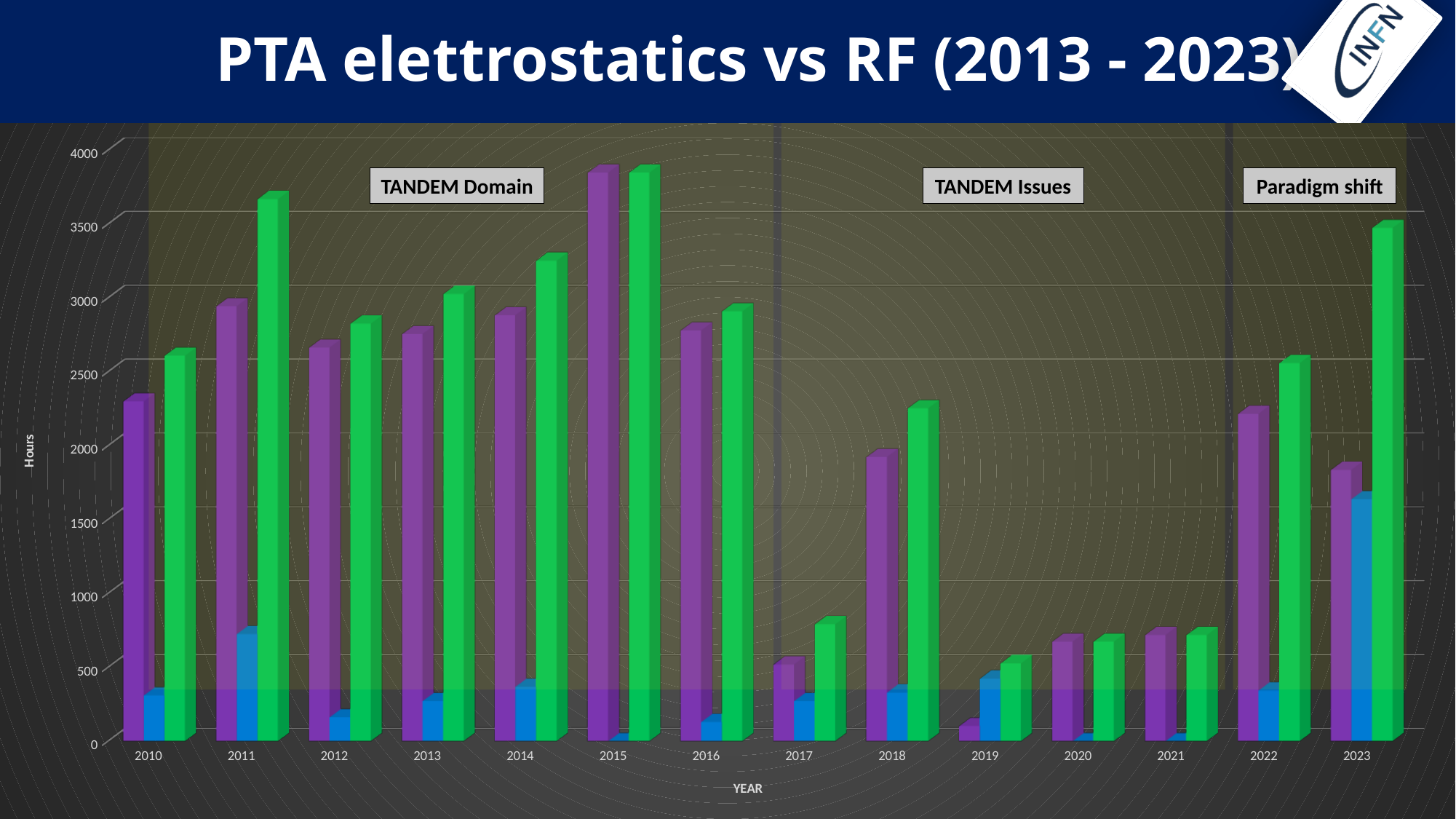
In which year is the purple bar the lowest? 2019 Is the value of the green bar for 2018 greater or less than 2000? greater Which year has the larger green bar, 2017 or 2018? 2018 Is the value of the purple bar for 2019 greater or less than 500? less What is the label of the vertical axis of the chart? Hours Is the value of the blue bar for 2023 greater or less than 1500? greater What kind of chart is shown on the slide? bar chart How many years are shown on the x axis of the chart? 14 Which year has the larger blue bar, 2011 or 2023? 2023 In which year is the green bar the tallest? 2015 Do the purple bars rise or fall from 2015 to 2017? fall